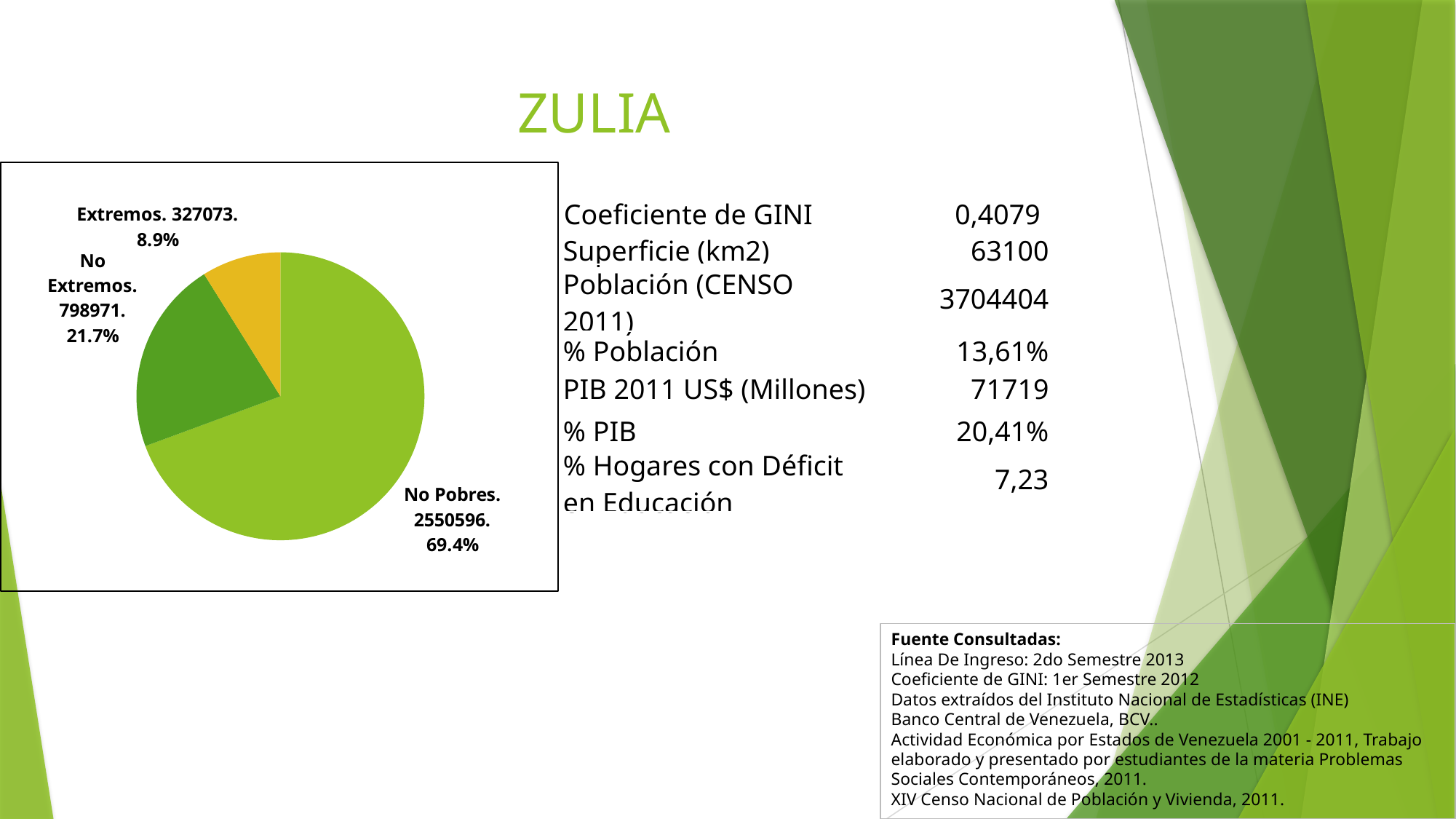
What is the value shown for the No Extremos slice? 798971 How many slices does the pie chart have? 3 What share of the pie does the No Pobres slice represent? 69.4% What is the value shown for the Extremos slice? 327073 Which is larger, the No Extremos slice or the Extremos slice? No Extremos What is the difference between the No Extremos value and the Extremos value? 471898 Which slice of the pie chart is the largest? No Pobres What is the value shown for the No Pobres slice? 2550596 What share of the pie does the No Extremos slice represent? 21.7% Which slice of the pie chart is the smallest? Extremos What share of the pie does the Extremos slice represent? 8.9% What kind of chart is shown on the slide? pie chart